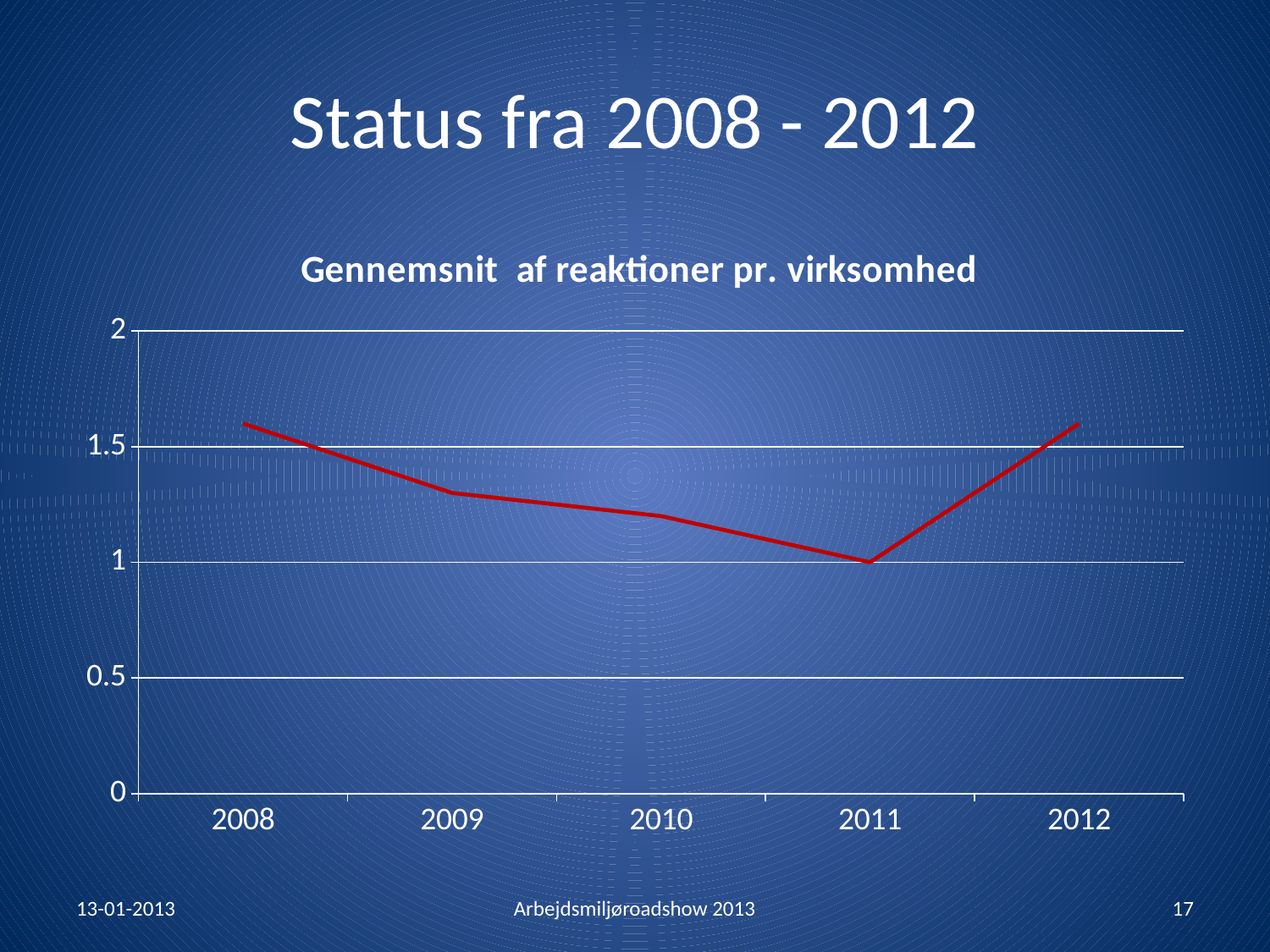
What kind of chart is shown on the slide? line chart Is the value for 2008 greater or less than 1.5? greater Is the value for 2009 greater or less than 1.5? less Which is larger, the value for 2008 or the value for 2011? 2008 Which is larger, the value for 2009 or the value for 2011? 2009 Is the value for 2012 greater or less than 1.5? greater What is the value for 2011 in the chart? 1 Do the values rise or fall from 2008 to 2011? fall What is the title of the chart? Gennemsnit af reaktioner pr. virksomhed Which year has the lowest value in the chart? 2011 How many years are plotted on the x axis of the chart? 5